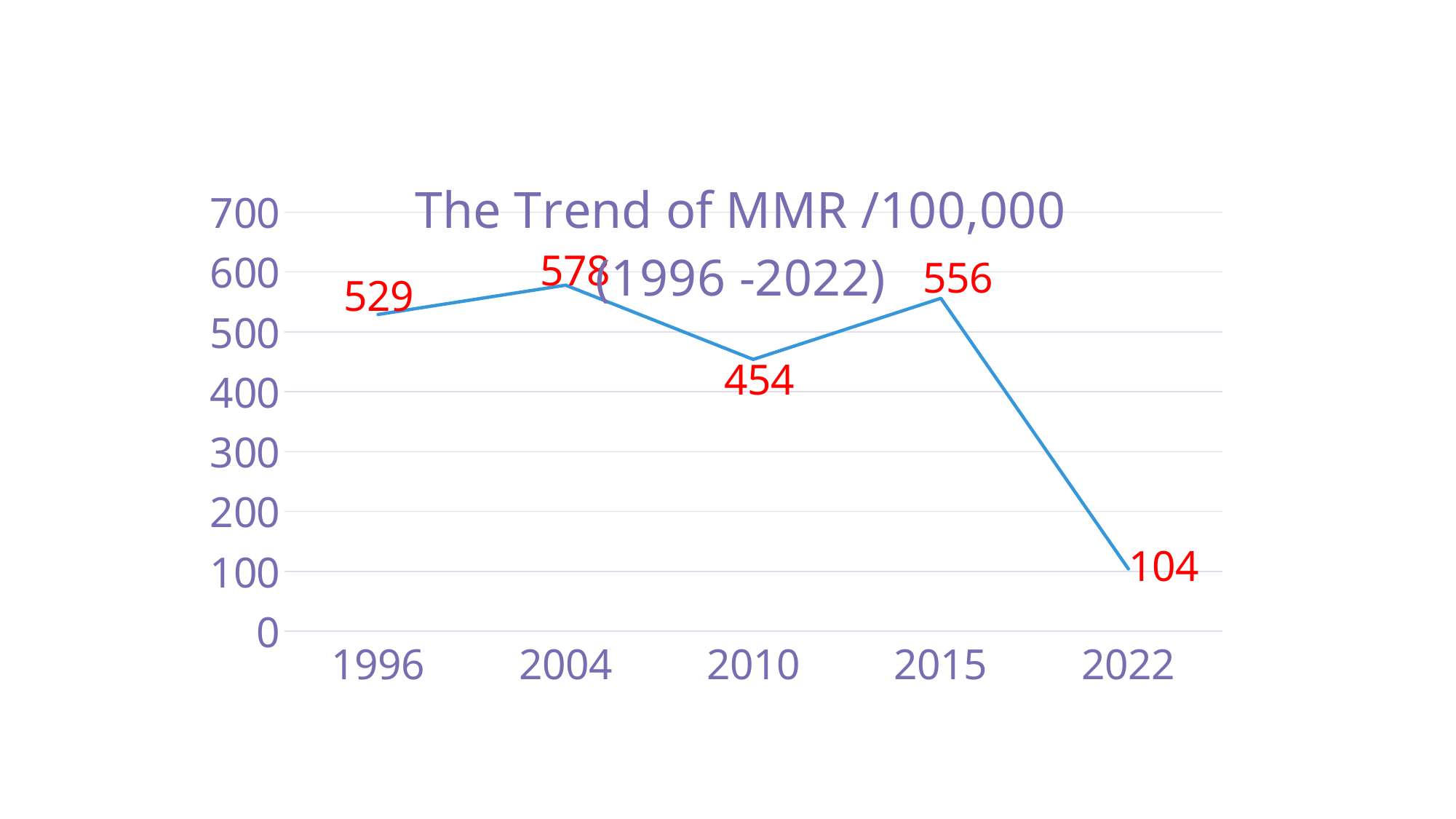
What is the title of the chart? The Trend of MMR /100,000 (1996 -2022) How many years are plotted on the chart? 5 Is the value for 2010 greater or less than 500? less What kind of chart is shown on the slide? line chart Which year has the lowest MMR value? 2022 Which year has the highest MMR value? 2004 What is the MMR value for 2022? 104 What is the MMR value for 2004? 578 Which is larger, the MMR value for 1996 or for 2010? 1996 What is the MMR value for 1996? 529 What is the difference between the MMR values for 2015 and 2022? 452 What is the MMR value for 2010? 454